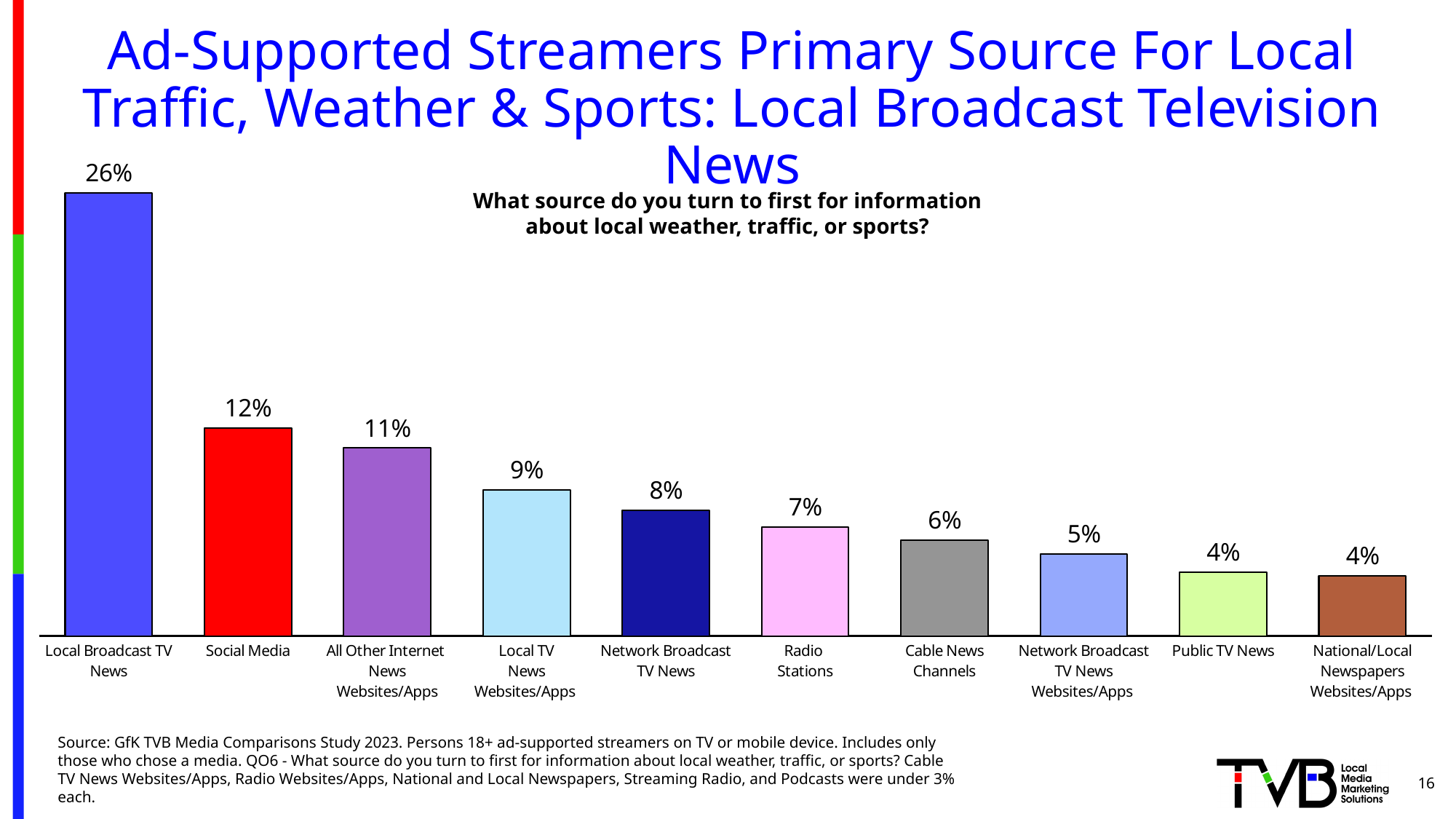
What is the difference between the values for Local Broadcast TV News and Social Media? 14% What percentage of ad-supported streamers turn first to Local Broadcast TV News for local weather, traffic, or sports? 26% Do the values rise or fall moving from left to right across the chart? Fall How many sources (bars) are shown on the chart? 10 Which source has the highest value on the chart? Local Broadcast TV News What is the value shown for Social Media? 12% What is the difference between the values for All Other Internet News Websites/Apps and Local TV News Websites/Apps? 2% What kind of chart is shown on the slide? Bar chart Which is larger, the value for Network Broadcast TV News or the value for Public TV News? Network Broadcast TV News What is the value shown for Radio Stations? 7% What question is shown as the chart's subtitle? What source do you turn to first for information about local weather, traffic, or sports? What is the value shown for Cable News Channels? 6%